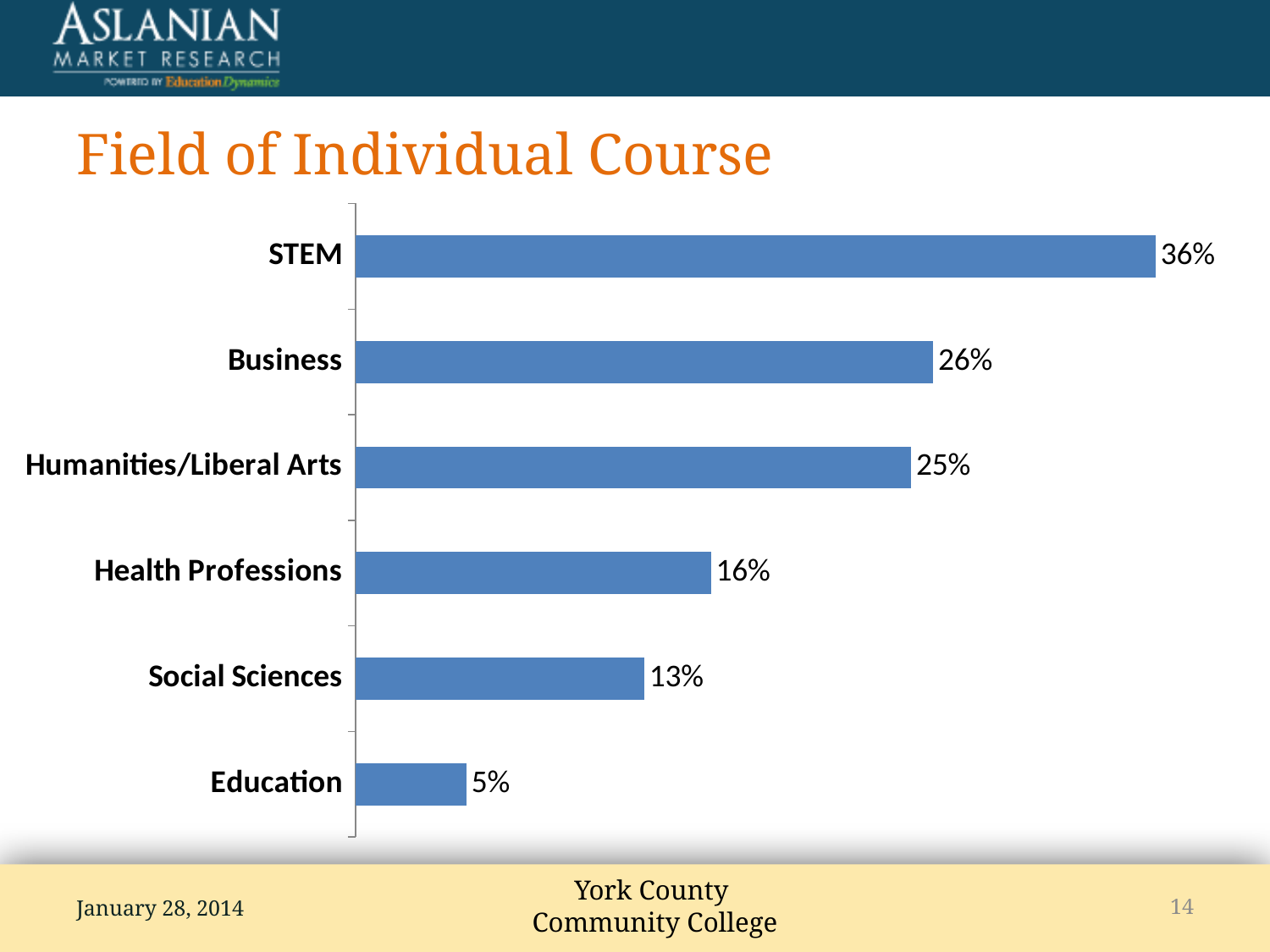
What is the value for STEM? 36% What is the value for Health Professions? 16% Which field has the highest value? STEM What is the difference between the values for STEM and Business? 10% Which field has the lowest value? Education What is the title of the slide? Field of Individual Course How many fields are shown in the chart? 6 Which is larger, the value for Business or the value for Humanities/Liberal Arts? Business What is the value for Education? 5% What is the difference between the values for Health Professions and Social Sciences? 3% Which is larger, the value for Social Sciences or the value for Education? Social Sciences What kind of chart is shown on the slide? Bar chart